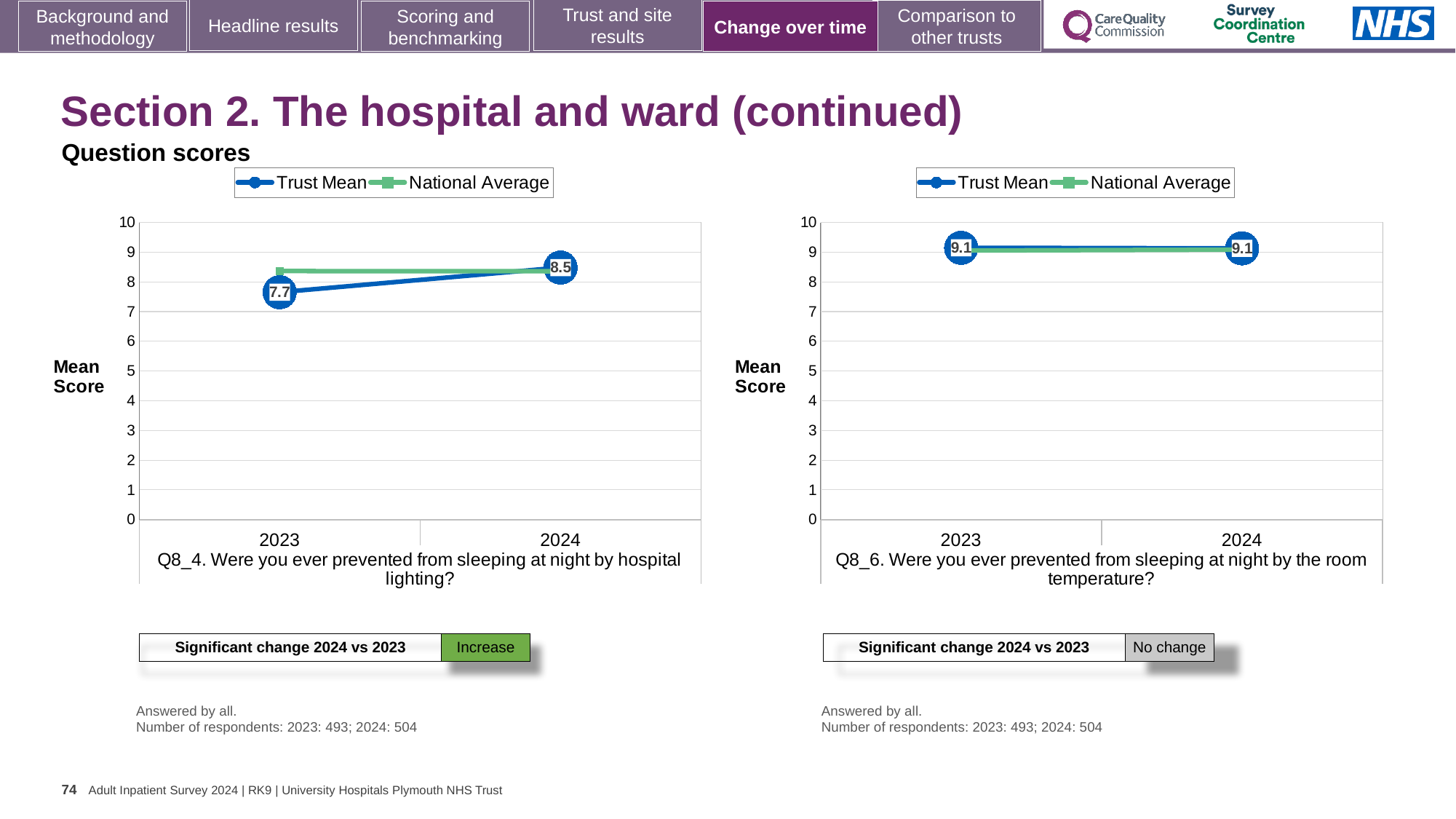
In the Q8_4 chart (left), what is the Trust Mean for 2024? 8.5 In the Q8_6 chart (right), does the Trust Mean rise, fall or stay the same from 2023 to 2024? stay the same How many series does the legend of the Q8_6 chart (right) list? 2 In the Q8_4 chart (left), is the National Average for 2023 greater or less than 8? greater What kind of chart is the Q8_4 chart on the left? line chart In the Q8_4 chart (left), by how much did the Trust Mean change from 2023 to 2024? 0.8 In the Q8_4 chart (left), what is the Trust Mean for 2023? 7.7 In the Q8_4 chart (left), does the Trust Mean rise or fall from 2023 to 2024? rise In the Q8_4 chart (left), which is larger for 2023: the Trust Mean or the National Average? National Average How many years are plotted on the x axis of the Q8_4 chart (left)? 2 In the Q8_6 chart (right), what is the Trust Mean for 2024? 9.1 What significant change is reported for the Q8_4 chart (left) for 2024 vs 2023? Increase